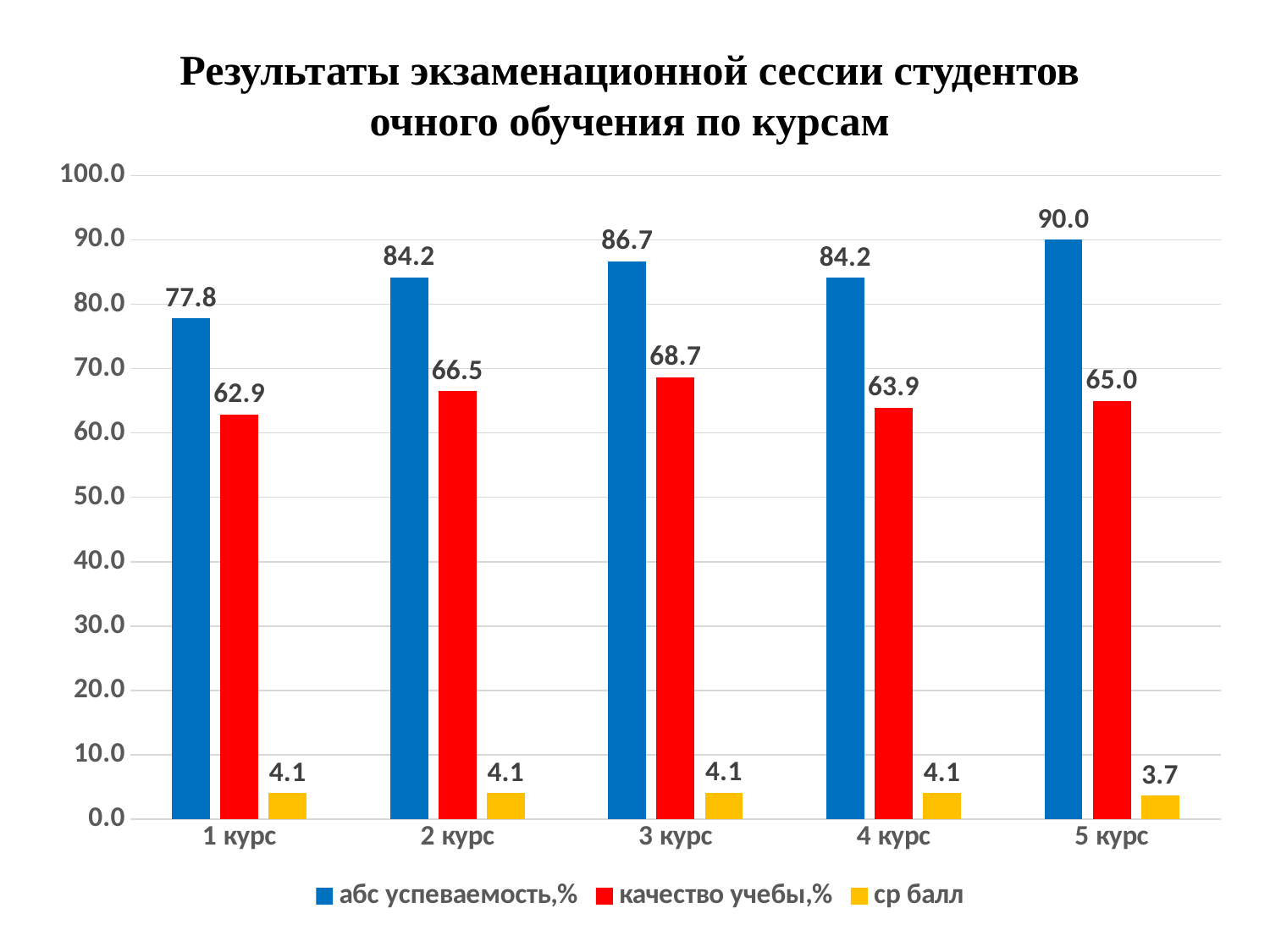
What is the difference between абс успеваемость,% for 5 курс and 1 курс? 12.2 What is the value of абс успеваемость,% for 1 курс? 77.8 How many series does the legend list? 3 Which course has the lowest качество учебы,%? 1 курс Which course has the highest абс успеваемость,%? 5 курс What kind of chart is shown on the slide? bar chart How many courses are shown on the x axis? 5 Is the value of абс успеваемость,% for 3 курс greater or less than 80.0? greater Which is larger: качество учебы,% for 2 курс or for 4 курс? 2 курс What is the value of ср балл for 5 курс? 3.7 What is the value of качество учебы,% for 3 курс? 68.7 Which colour represents ср балл in the chart? yellow